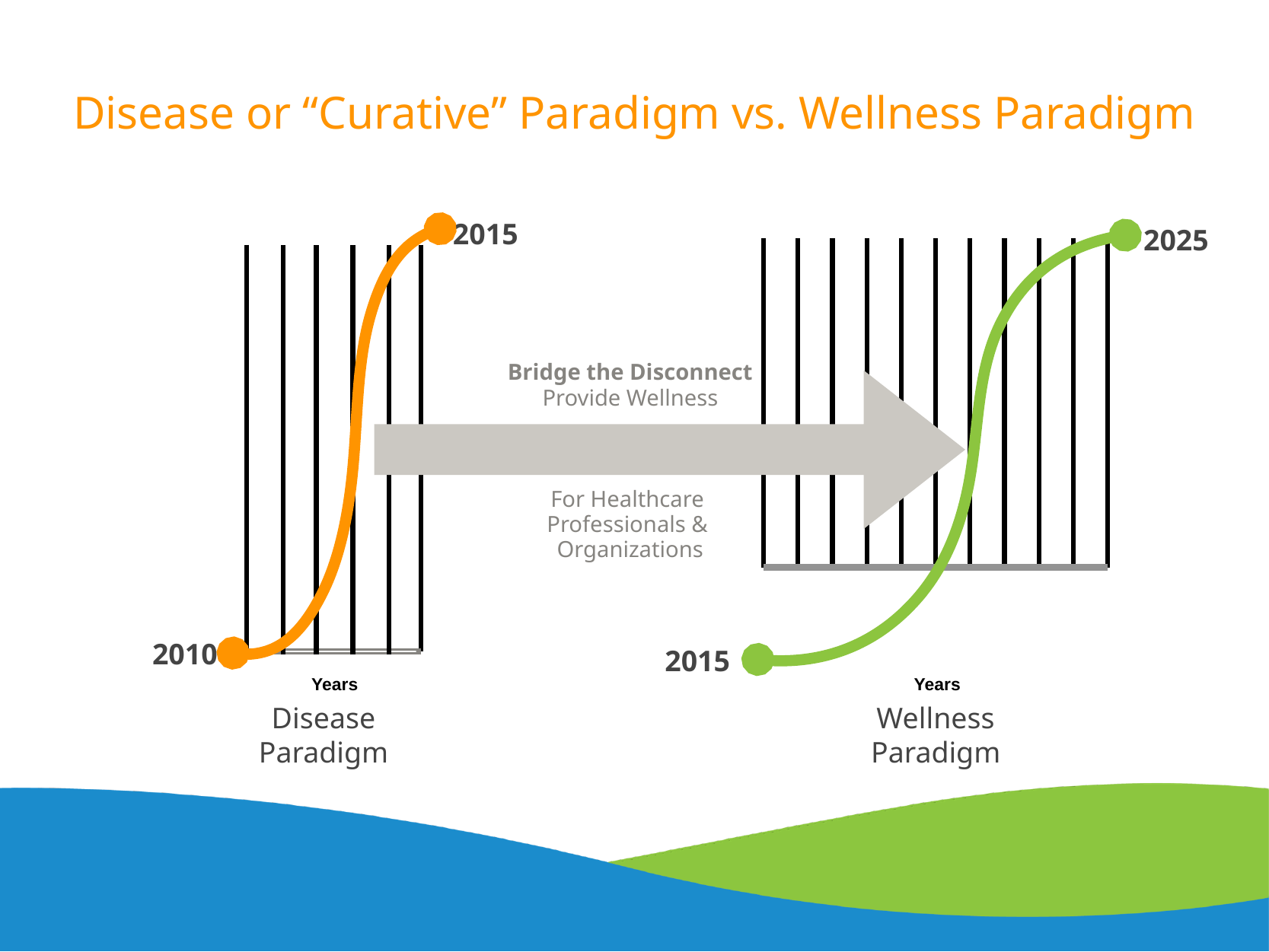
On the Disease Paradigm chart, what year label is at the end of the orange curve? 2015 On the Wellness Paradigm chart, what year label is at the start of the green curve? 2015 On the Disease Paradigm chart, what year label is at the start of the orange curve? 2010 On the Disease Paradigm chart, does the curve rise or fall from left to right? rise How many charts are shown on the slide? 2 What colour is the curve on the Wellness Paradigm chart? Green On the Wellness Paradigm chart, what year label is at the end of the green curve? 2025 What is the x-axis label on the Disease Paradigm chart? Years On the Wellness Paradigm chart, does the curve rise or fall from left to right? rise